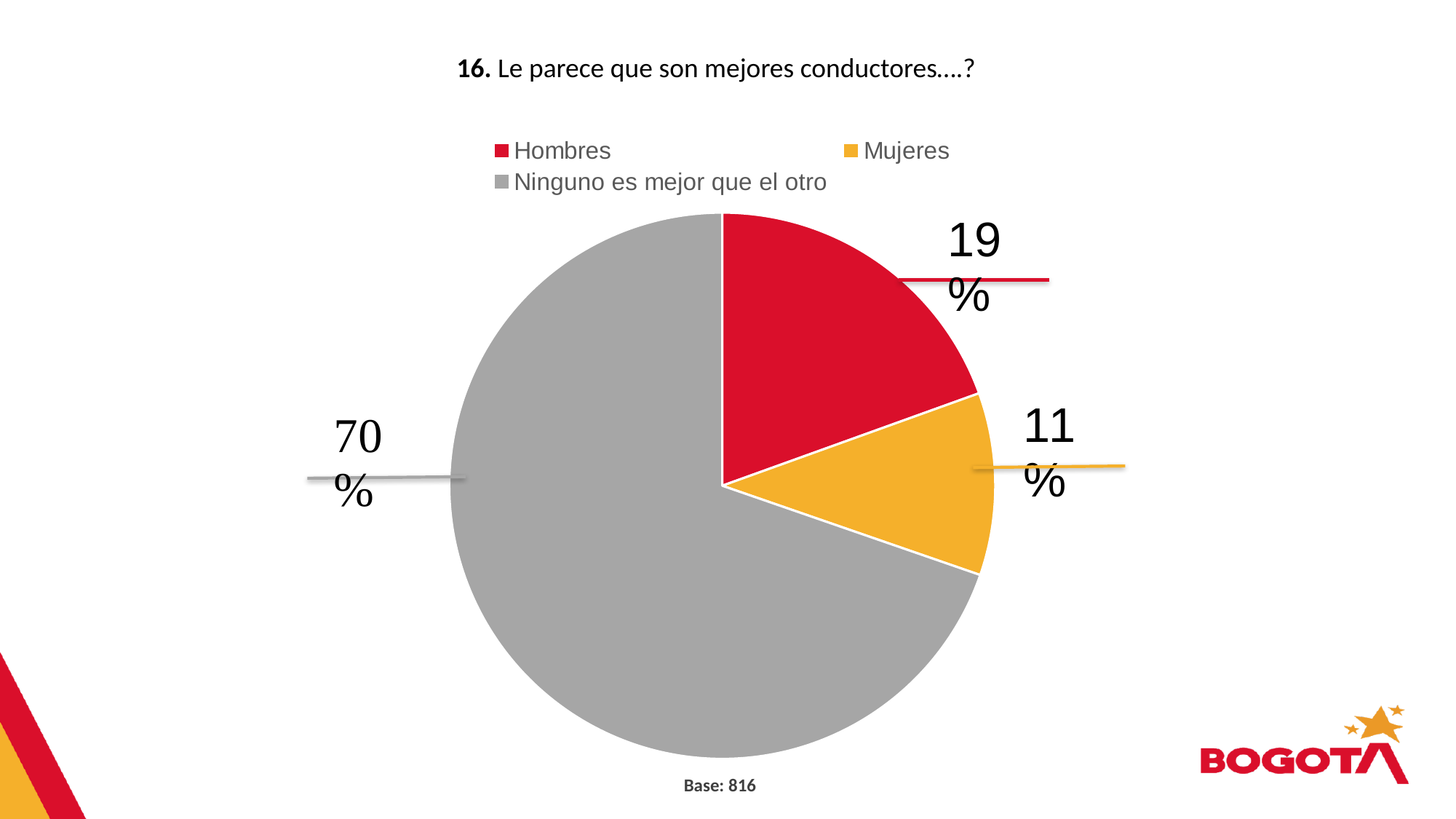
Which category has the smallest share of the pie? Mujeres What is the difference in percentage points between "Hombres" and "Mujeres"? 8 What kind of chart is shown on the slide? pie chart What is the base (number of respondents) shown below the chart? 816 How many categories does the pie chart have? 3 What percentage of respondents answered "Mujeres"? 11% What percentage of respondents answered "Ninguno es mejor que el otro"? 70% What is the difference in percentage points between "Ninguno es mejor que el otro" and "Hombres"? 51 What colour is the slice for "Mujeres"? yellow Which category has the largest share of the pie? Ninguno es mejor que el otro What percentage of respondents answered "Hombres"? 19% Which is larger, the share for "Hombres" or the share for "Mujeres"? Hombres